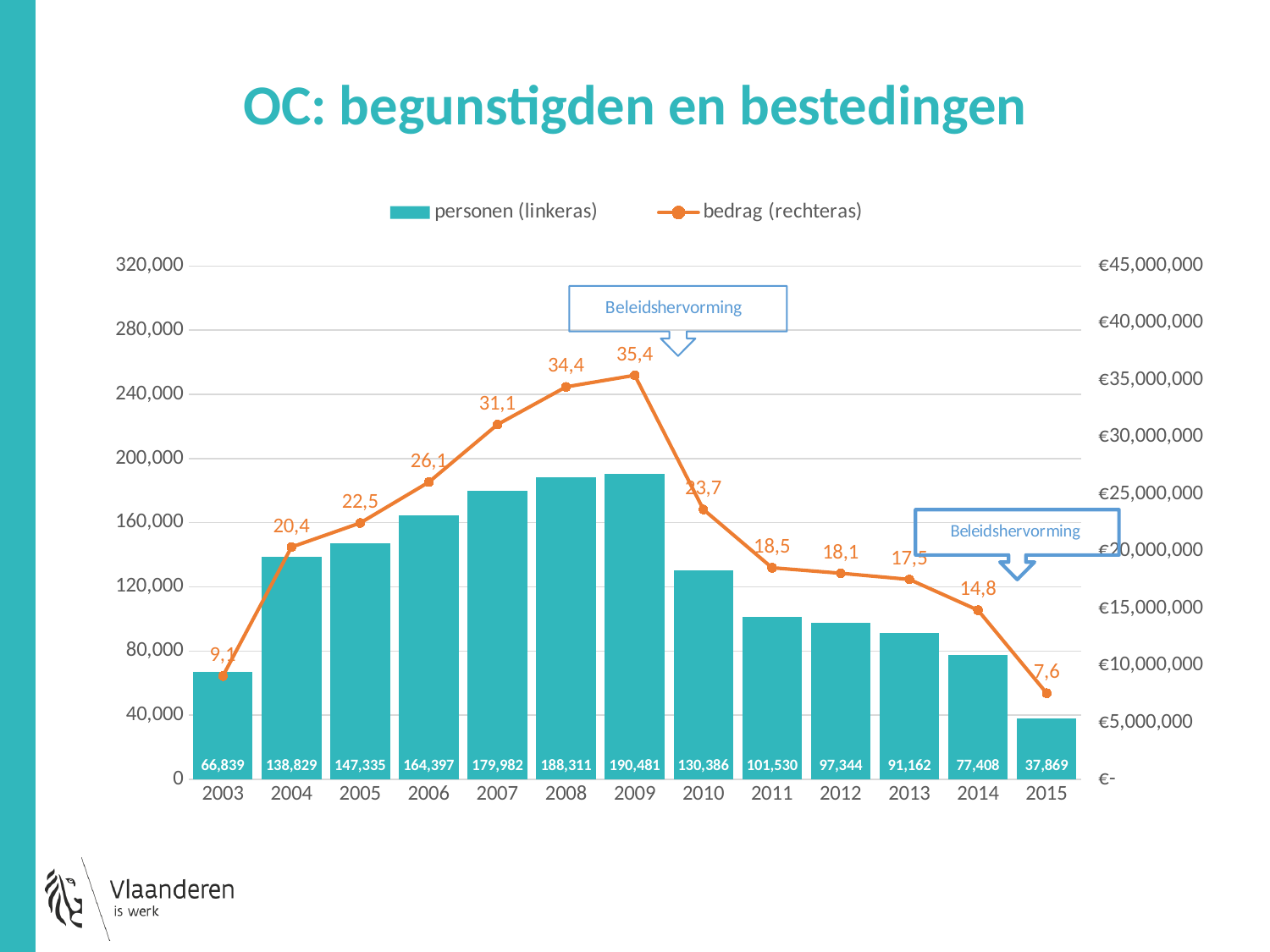
How many years are shown on the x axis? 13 Which year has the lowest value for personen (linkeras)? 2015 What is the value of personen (linkeras) for 2015? 37,869 What is the value of bedrag (rechteras) for 2008? 34,4 Which year has the highest value for bedrag (rechteras)? 2009 Does the bedrag (rechteras) line rise or fall from 2009 to 2015? fall What is the difference between the personen (linkeras) values for 2009 and 2010? 60,095 What kind of chart is used for the personen (linkeras) series? bar chart What is the title of the slide? OC: begunstigden en bestedingen Which is larger, the personen (linkeras) value for 2004 or for 2005? 2005 How many series does the legend list? 2 What is the value of personen (linkeras) for 2009? 190,481